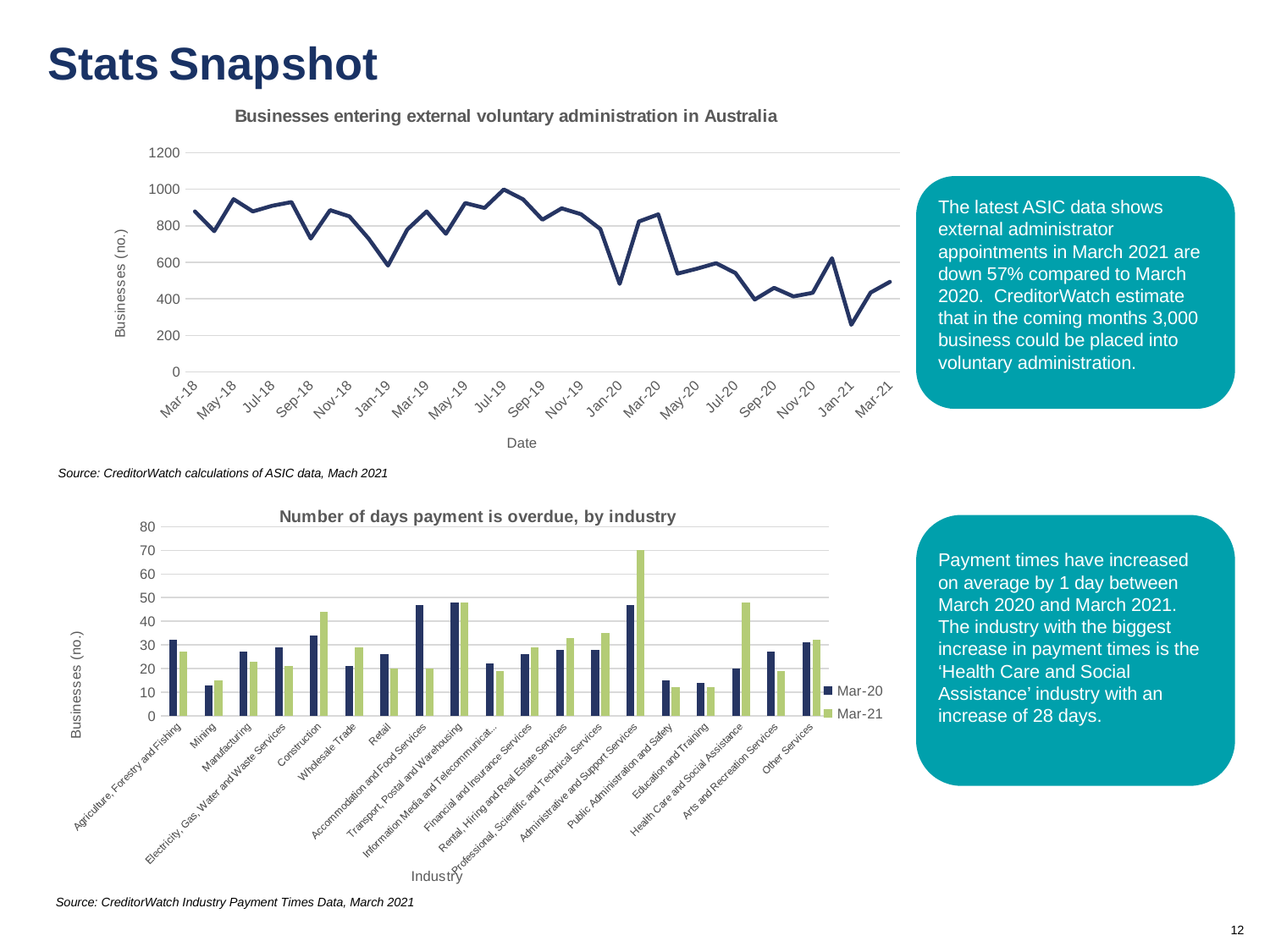
In the top chart, 'Businesses entering external voluntary administration in Australia', is the value for Jul-19 greater or less than 800? greater In the top chart, 'Businesses entering external voluntary administration in Australia', which date has the lowest value? Jan-21 What kind of chart is the bottom chart, 'Number of days payment is overdue, by industry'? Bar chart In the bottom chart, 'Number of days payment is overdue, by industry', is the Mar-21 value for Administrative and Support Services greater or less than 60? greater In the top chart, 'Businesses entering external voluntary administration in Australia', is the value for Jan-21 greater or less than 400? less What kind of chart is the top chart, 'Businesses entering external voluntary administration in Australia'? Line chart In the bottom chart, 'Number of days payment is overdue, by industry', which is larger for Health Care and Social Assistance: the Mar-20 value or the Mar-21 value? Mar-21 How many industries are shown on the x axis of the bottom chart, 'Number of days payment is overdue, by industry'? 19 In the bottom chart, 'Number of days payment is overdue, by industry', which industry has the lowest Mar-20 value? Mining How many series does the legend of the bottom chart, 'Number of days payment is overdue, by industry', list? 2 In the bottom chart, 'Number of days payment is overdue, by industry', which industry has the highest Mar-21 value? Administrative and Support Services In the top chart, 'Businesses entering external voluntary administration in Australia', do the values overall rise or fall from Mar-18 to Mar-21? Fall